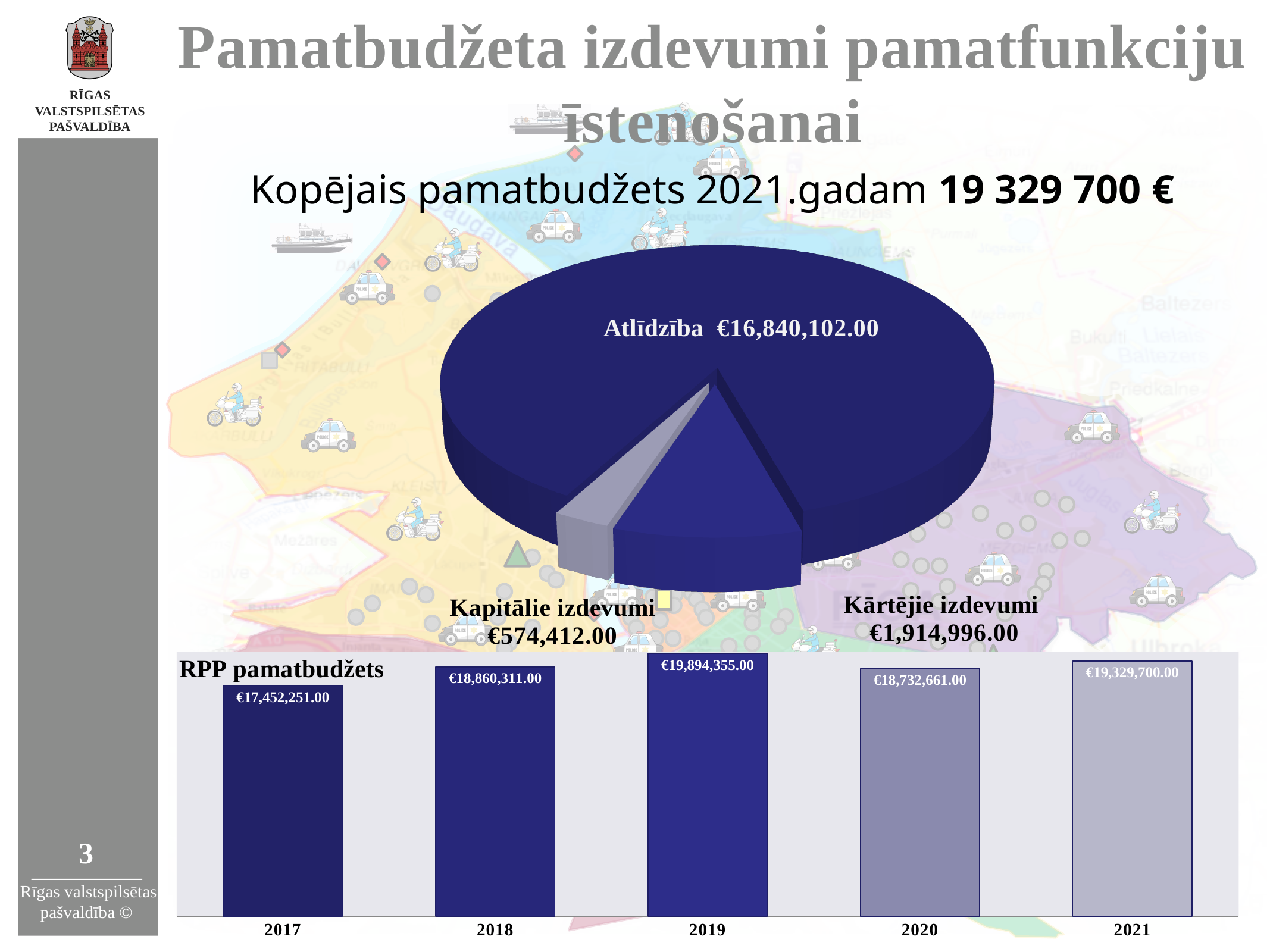
In the RPP pamatbudžets bar chart, which year has the lowest value? 2017 In the pie chart, which category has the largest slice? Atlīdzība In the pie chart, what is the value for Atlīdzība? €16,840,102.00 In the pie chart, which category has the smallest slice? Kapitālie izdevumi What type of chart is the RPP pamatbudžets chart at the bottom of the slide? bar chart In the pie chart, what is the value for Kapitālie izdevumi? €574,412.00 In the RPP pamatbudžets bar chart, which year has the highest value? 2019 In the RPP pamatbudžets bar chart, what is the value for 2021? €19,329,700.00 In the pie chart, how many slices are there? 3 In the RPP pamatbudžets bar chart, what is the difference between the 2021 and 2020 values? €597,039.00 In the RPP pamatbudžets bar chart, what is the value for 2019? €19,894,355.00 In the pie chart, which is larger: Kārtējie izdevumi or Kapitālie izdevumi? Kārtējie izdevumi